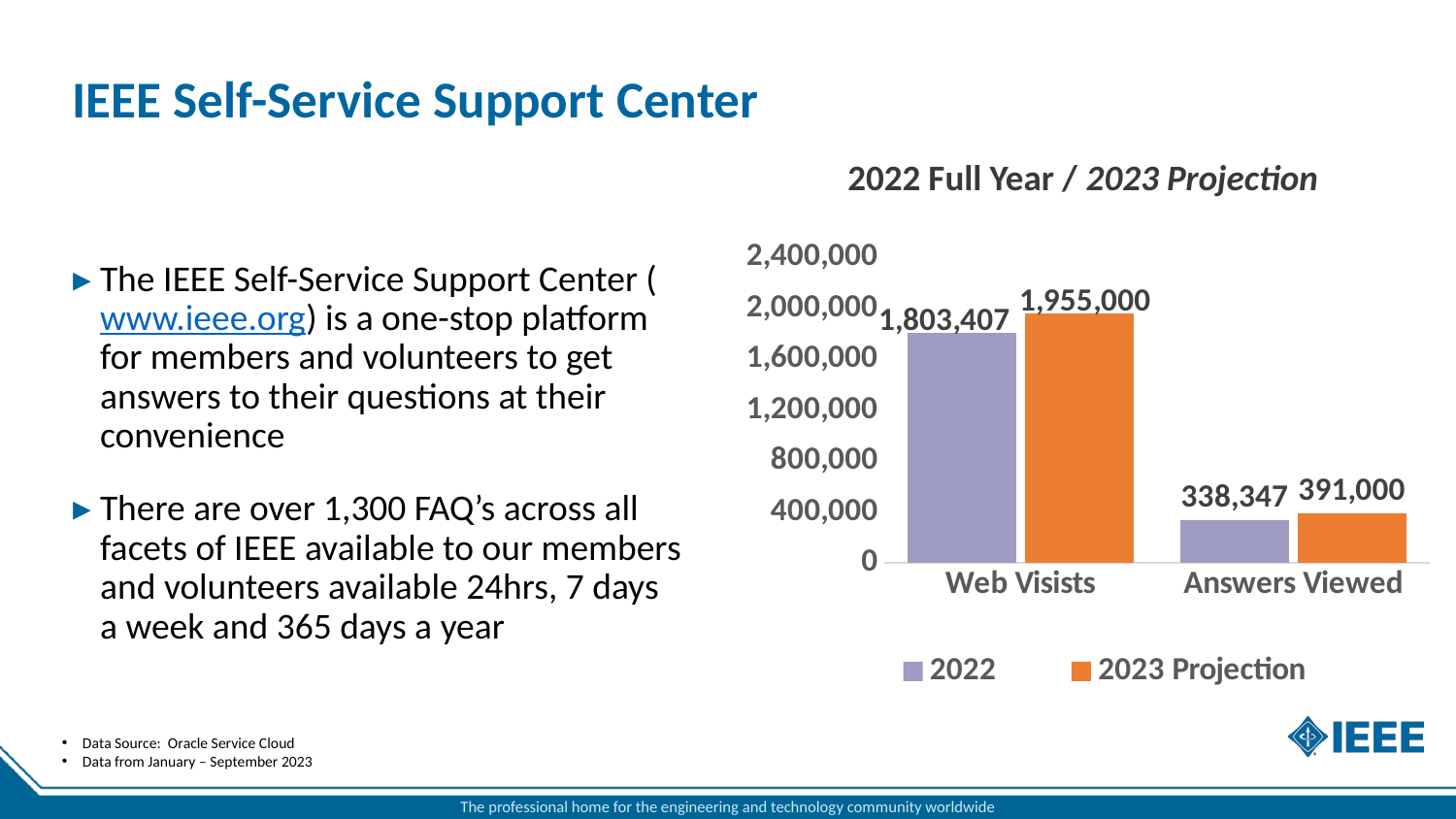
Which category has the lowest 2023 Projection value? Answers Viewed What is the 2023 Projection value for Answers Viewed? 391,000 What is the difference between the 2023 Projection and 2022 values for Answers Viewed? 52,653 How many categories are shown on the x axis? 2 Which category has the highest 2022 value? Web Visists Which is larger for Answers Viewed: the 2022 value or the 2023 Projection value? 2023 Projection What is the 2023 Projection value for Web Visists? 1,955,000 What is the difference between the 2023 Projection and 2022 values for Web Visists? 151,593 What is the 2022 value for Answers Viewed? 338,347 What is the 2022 value for Web Visists? 1,803,407 How many series does the legend list? 2 What kind of chart is shown on the slide? Bar chart